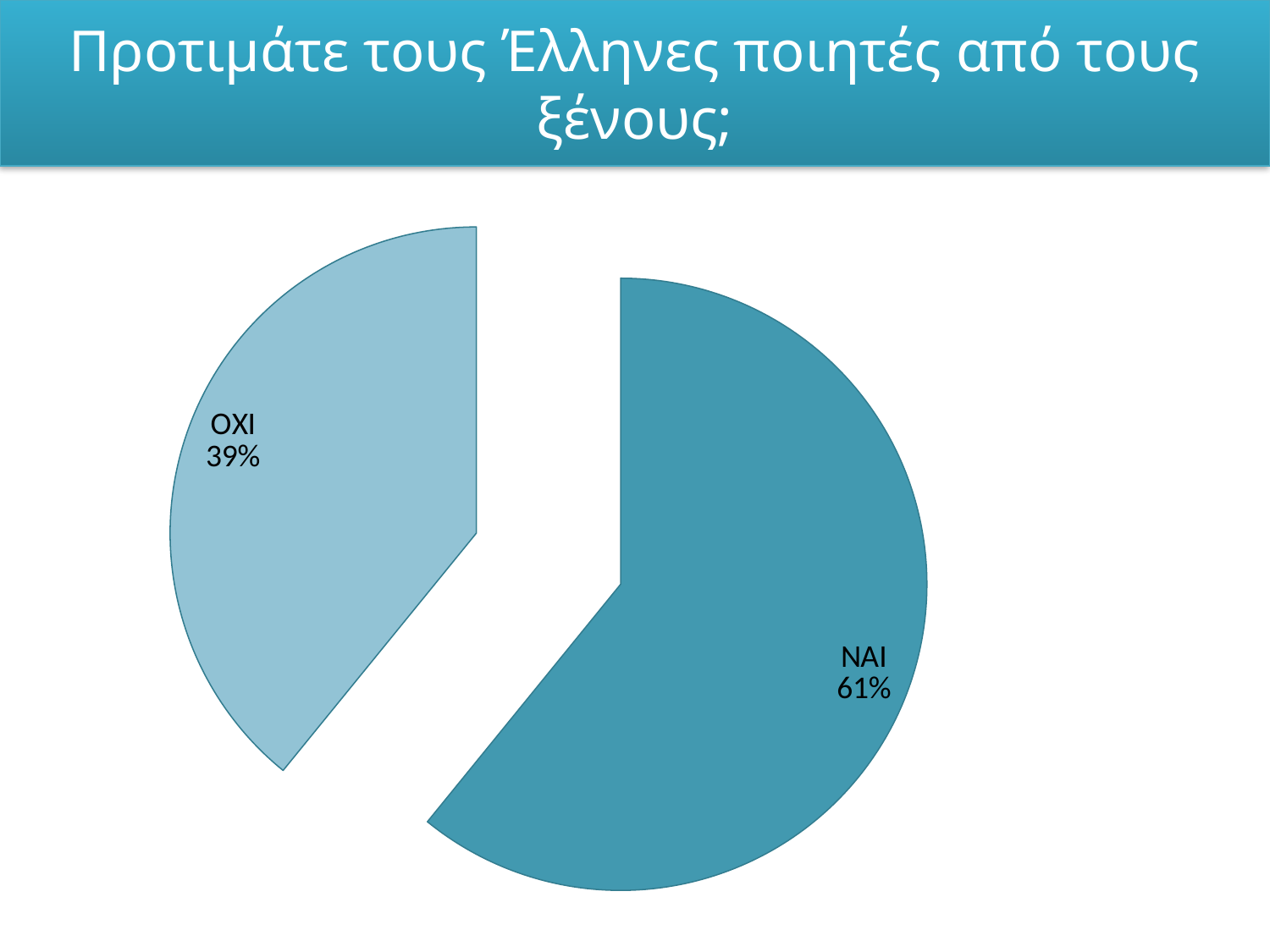
What kind of chart is shown on the slide? pie chart What is the difference in percentage points between the ΝΑΙ and ΟΧΙ slices? 22 Which slice of the pie is shown in the lighter blue colour? ΟΧΙ Which slice of the pie is the largest? ΝΑΙ What percentage of the pie is labelled ΝΑΙ? 61% What is the title of the slide containing the pie chart? Προτιμάτε τους Έλληνες ποιητές από τους ξένους; Which is larger, the ΝΑΙ slice or the ΟΧΙ slice? ΝΑΙ What share of the pie does the ΟΧΙ slice represent? 39% Which slice of the pie is the smallest? ΟΧΙ What percentage of the pie is labelled ΟΧΙ? 39% How many slices does the pie chart have? 2